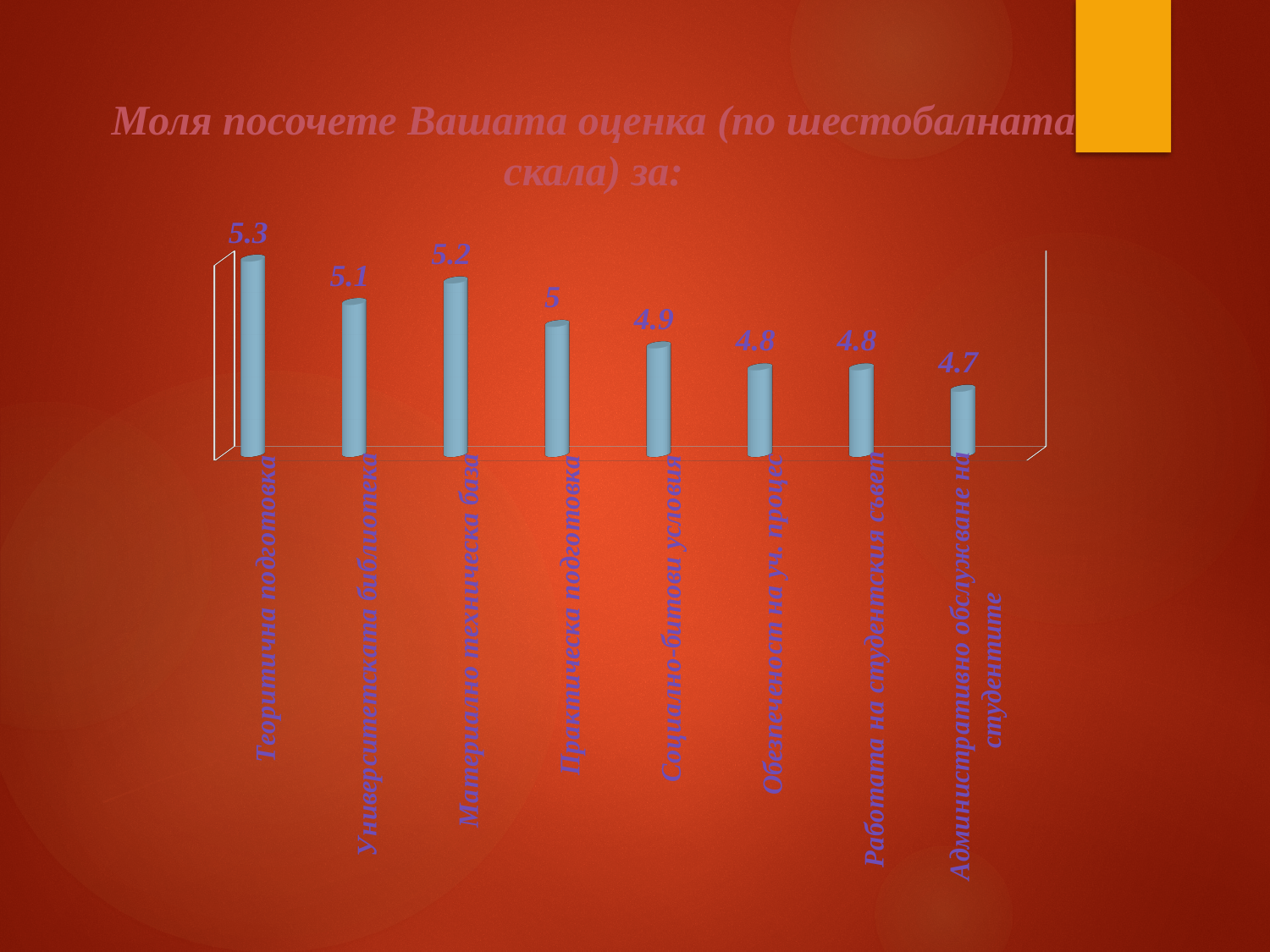
What is the difference between the values for Теоритична подготовка and Административно обслужване на студентите? 0.6 What kind of chart is shown on the slide? Bar chart Which category has the highest value? Теоритична подготовка What is the value for Университетската библиотека? 5.1 What is the title of the chart? Моля посочете Вашата оценка (по шестобалната скала) за: What is the value for Административно обслужване на студентите? 4.7 What is the value for Материално техническа база? 5.2 How many categories are shown in the chart? 8 What is the value for Практическа подготовка? 5 Which category has the lowest value? Административно обслужване на студентите What is the value for Теоритична подготовка? 5.3 Which is larger, the value for Университетската библиотека or the value for Материално техническа база? Материално техническа база